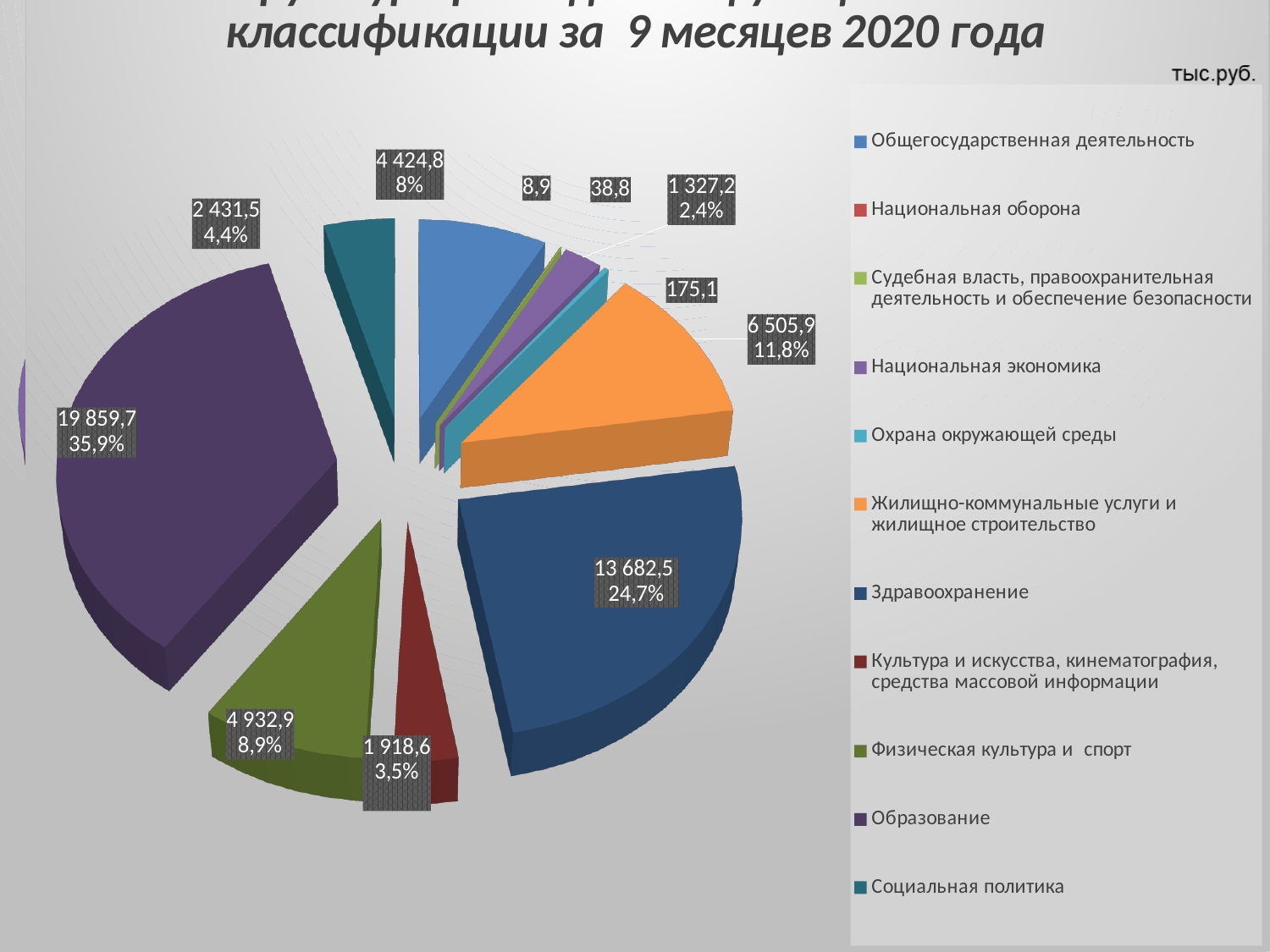
What is the value for Жилищно-коммунальные услуги и жилищное строительство? 6 505,9 What kind of chart is shown on the slide? Pie chart What is the value for Образование? 19 859,7 What is the value for Здравоохранение? 13 682,5 What share of the pie does Физическая культура и спорт account for? 8,9% How many categories does the legend of the pie chart list? 11 What unit of measurement is indicated for the chart values? тыс.руб. Which category has the smallest slice of the pie? Национальная оборона What share of the pie does Здравоохранение account for? 24,7% Which is larger, the value for Общегосударственная деятельность or the value for Физическая культура и спорт? Физическая культура и спорт Which category has the largest slice of the pie? Образование What is the value for Социальная политика? 2 431,5